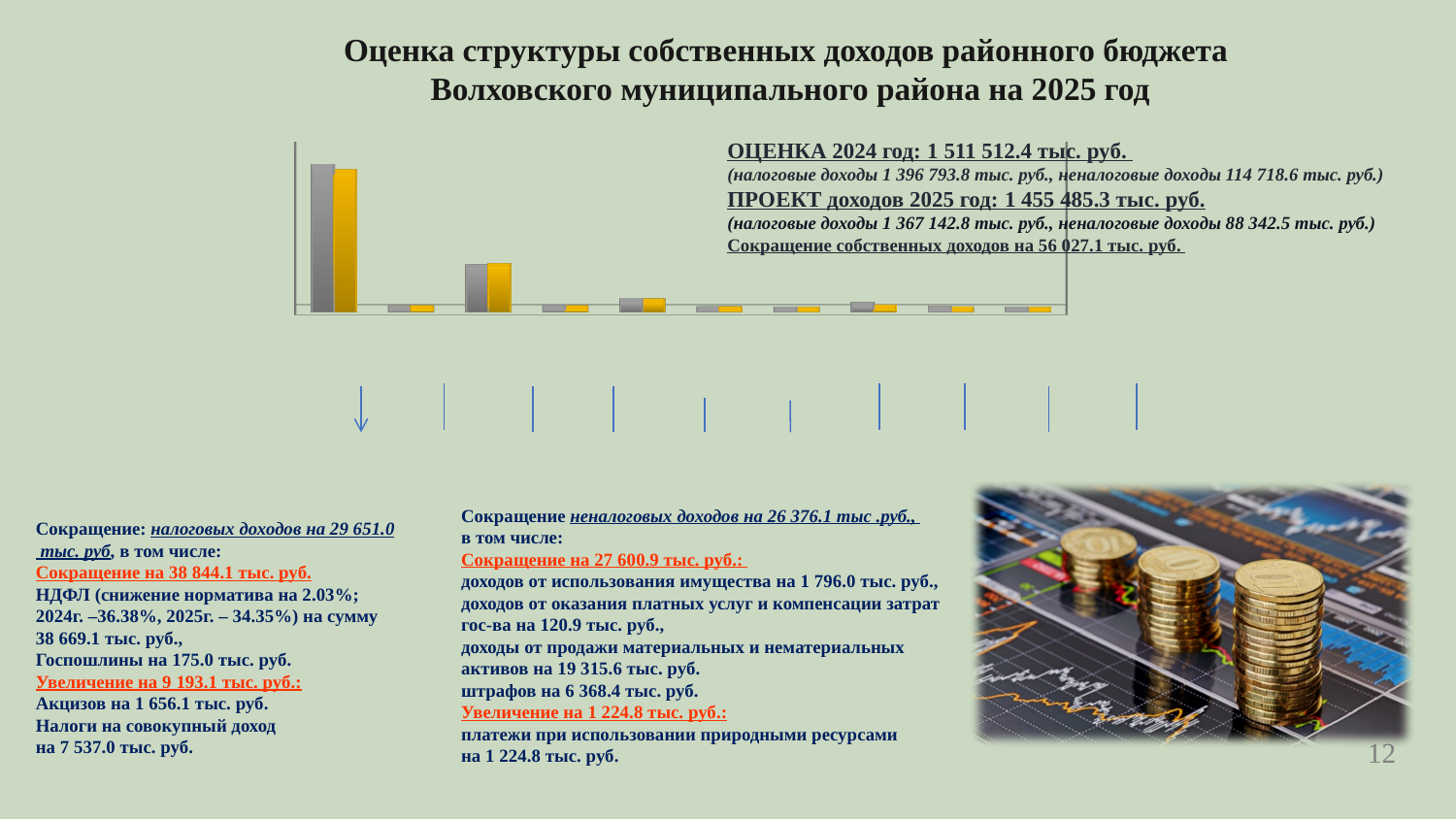
What kind of chart is shown on the slide? bar chart How many bars are there in each category group of the chart? 2 What two colours are used for the bars in the chart? gray and yellow How many groups of bars (categories) are plotted in the chart? 10 Which category group has the tallest bars: the leftmost group or the third group from the left? the leftmost group